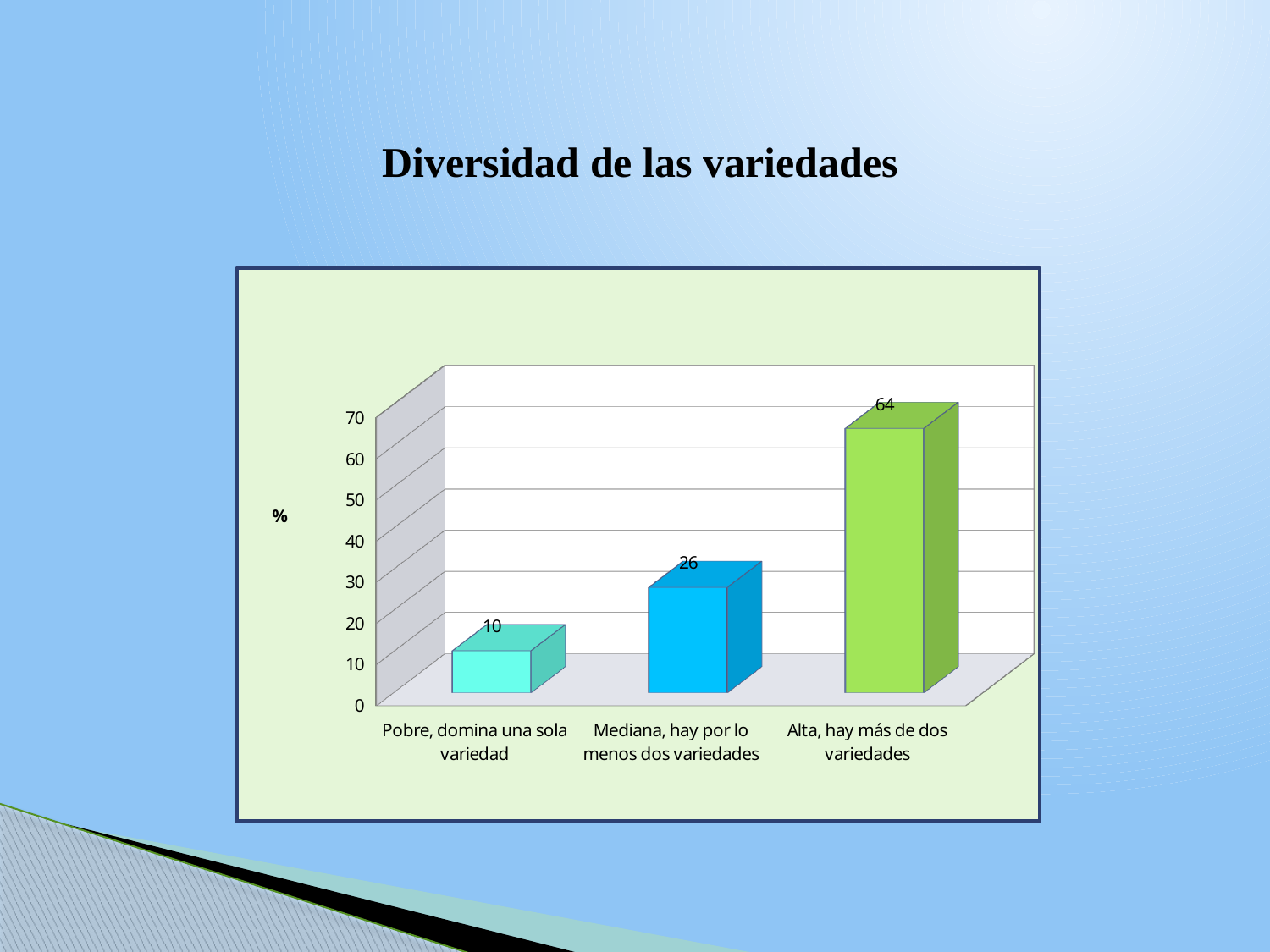
Which is larger, the value for "Mediana, hay por lo menos dos variedades" or for "Pobre, domina una sola variedad"? Mediana, hay por lo menos dos variedades How many categories are shown on the x axis? 3 Which category has the highest value? Alta, hay más de dos variedades What is the difference between the values for "Alta, hay más de dos variedades" and "Mediana, hay por lo menos dos variedades"? 38 What is the title of the chart? Diversidad de las variedades What is the value for "Pobre, domina una sola variedad"? 10 What is the value for "Mediana, hay por lo menos dos variedades"? 26 Is the value for "Alta, hay más de dos variedades" greater or less than 50? greater What is the difference between the values for "Mediana, hay por lo menos dos variedades" and "Pobre, domina una sola variedad"? 16 What is the value for "Alta, hay más de dos variedades"? 64 Which category has the lowest value? Pobre, domina una sola variedad What kind of chart is shown on the slide? bar chart